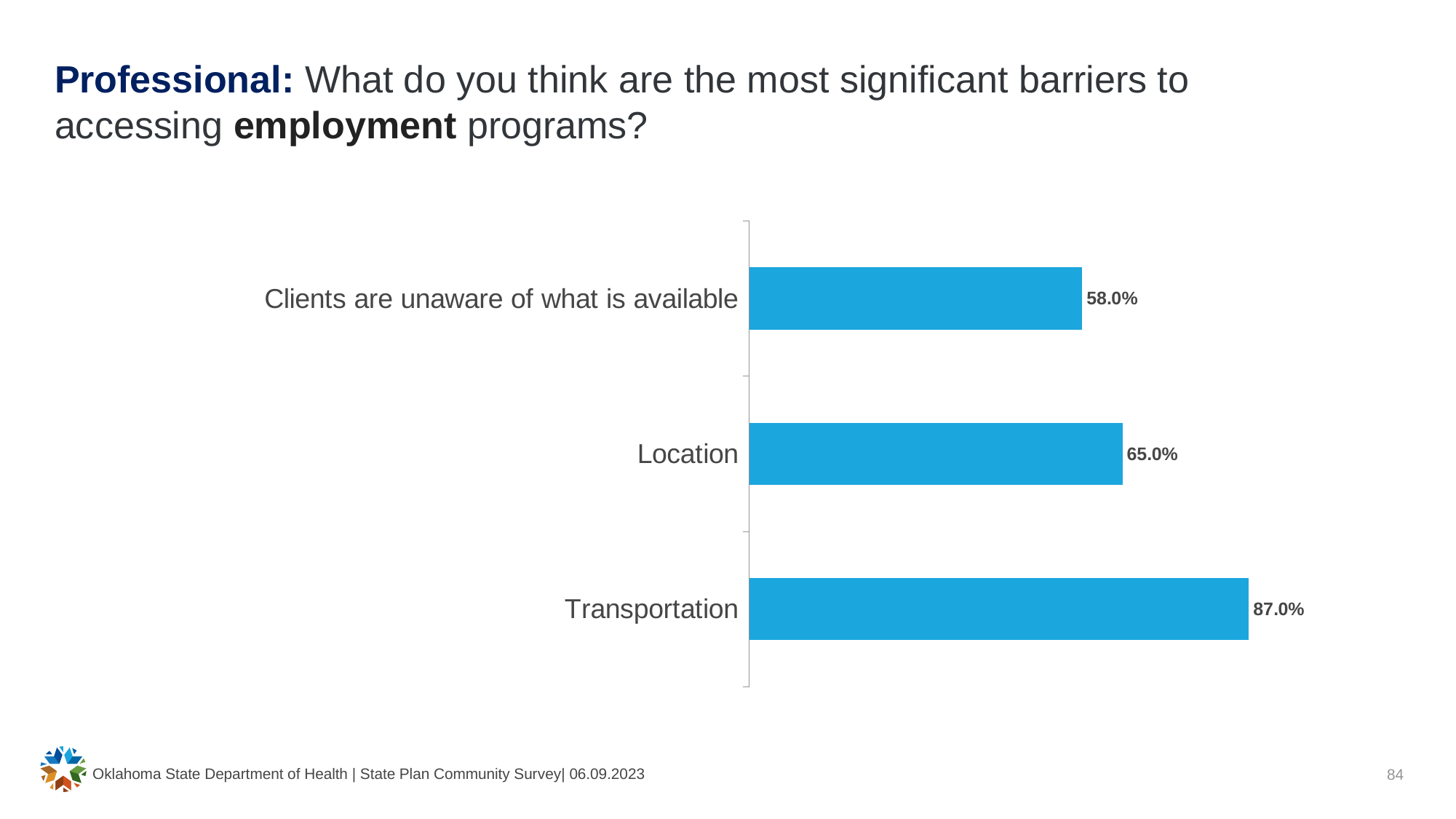
Which category is listed at the bottom of the chart? Transportation How many categories are shown in the chart? 3 What colour are the bars in the chart? Blue What is the value for Location? 65.0% Which category has the highest value? Transportation What is the difference between the values for Location and 'Clients are unaware of what is available'? 7.0% What is the value for Transportation? 87.0% Which category has the lowest value? Clients are unaware of what is available What is the value for 'Clients are unaware of what is available'? 58.0% What is the difference between the values for Transportation and Location? 22.0% What kind of chart is shown on the slide? Bar chart Which is larger, the value for Location or the value for 'Clients are unaware of what is available'? Location